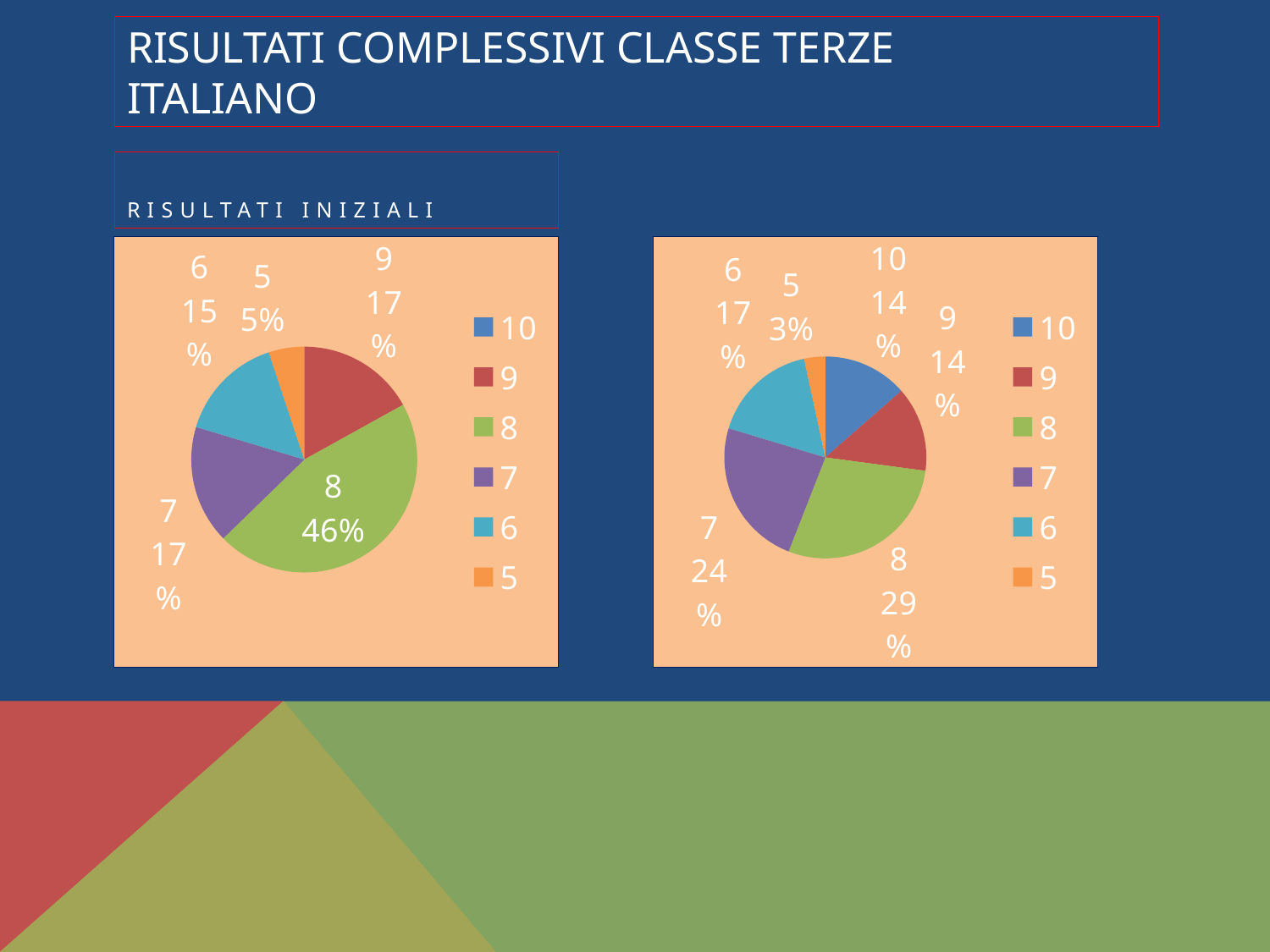
In the left pie chart (Risultati iniziali), what share does grade 5 have? 5% In the right pie chart, which grade has the smallest share? 5 In the left pie chart (Risultati iniziali), what share does grade 8 have? 46% In the right pie chart, what share does grade 10 have? 14% How many entries does the legend of the right pie chart list? 6 In the right pie chart, which grade has the largest share? 8 What type of chart is shown on the left of the slide? Pie chart In the left pie chart (Risultati iniziali), what is the difference between the share for grade 8 and the share for grade 6? 31% In the left pie chart (Risultati iniziali), which grade has the largest share? 8 In the right pie chart, which has the larger share, grade 7 or grade 6? 7 In the left pie chart (Risultati iniziali), which labelled grade has the smallest share? 5 In the right pie chart, what share does grade 7 have? 24%